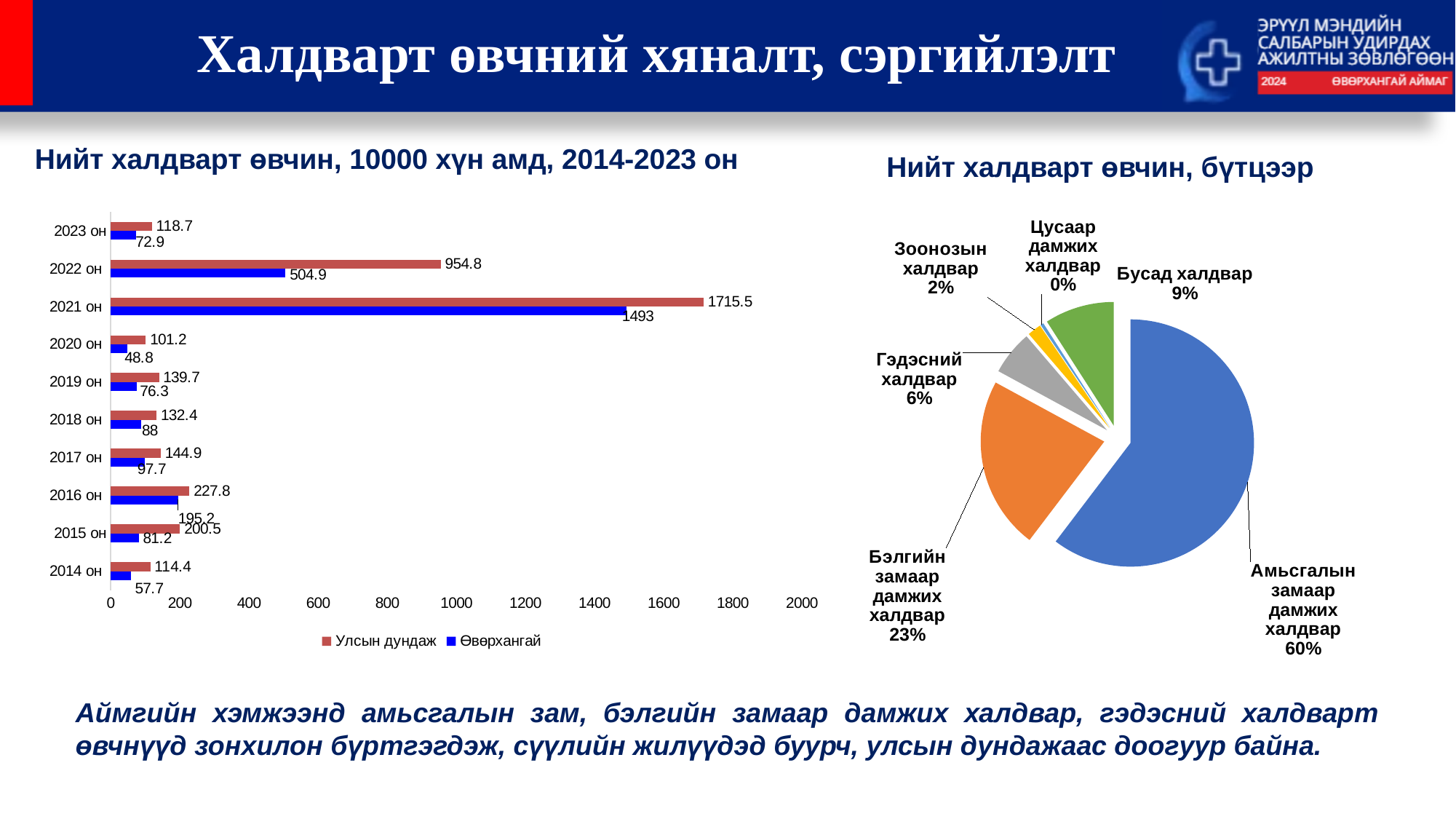
In the bar chart 'Нийт халдварт өвчин, 10000 хүн амд, 2014-2023 он', what is the value for Улсын дундаж in 2022? 954.8 In the bar chart 'Нийт халдварт өвчин, 10000 хүн амд, 2014-2023 он', what is the difference between Улсын дундаж and Өвөрхангай in 2021? 222.5 What type of chart is the chart on the right, 'Нийт халдварт өвчин, бүтцээр'? Pie chart In the bar chart 'Нийт халдварт өвчин, 10000 хүн амд, 2014-2023 он', what is the value for Өвөрхангай in 2023? 72.9 In the bar chart 'Нийт халдварт өвчин, 10000 хүн амд, 2014-2023 он', which year has the lowest value for Өвөрхангай? 2020 он In the pie chart 'Нийт халдварт өвчин, бүтцээр', what share does Амьсгалын замаар дамжих халдвар have? 60% In the bar chart 'Нийт халдварт өвчин, 10000 хүн амд, 2014-2023 он', which is larger in 2015: Улсын дундаж or Өвөрхангай? Улсын дундаж How many series does the legend of the bar chart 'Нийт халдварт өвчин, 10000 хүн амд, 2014-2023 он' list? 2 In the pie chart 'Нийт халдварт өвчин, бүтцээр', which category has the smallest share? Цусаар дамжих халдвар In the bar chart 'Нийт халдварт өвчин, 10000 хүн амд, 2014-2023 он', which year has the highest value for Улсын дундаж? 2021 он How many years are shown in the bar chart 'Нийт халдварт өвчин, 10000 хүн амд, 2014-2023 он'? 10 In the bar chart 'Нийт халдварт өвчин, 10000 хүн амд, 2014-2023 он', what is the value for Өвөрхангай in 2021? 1493